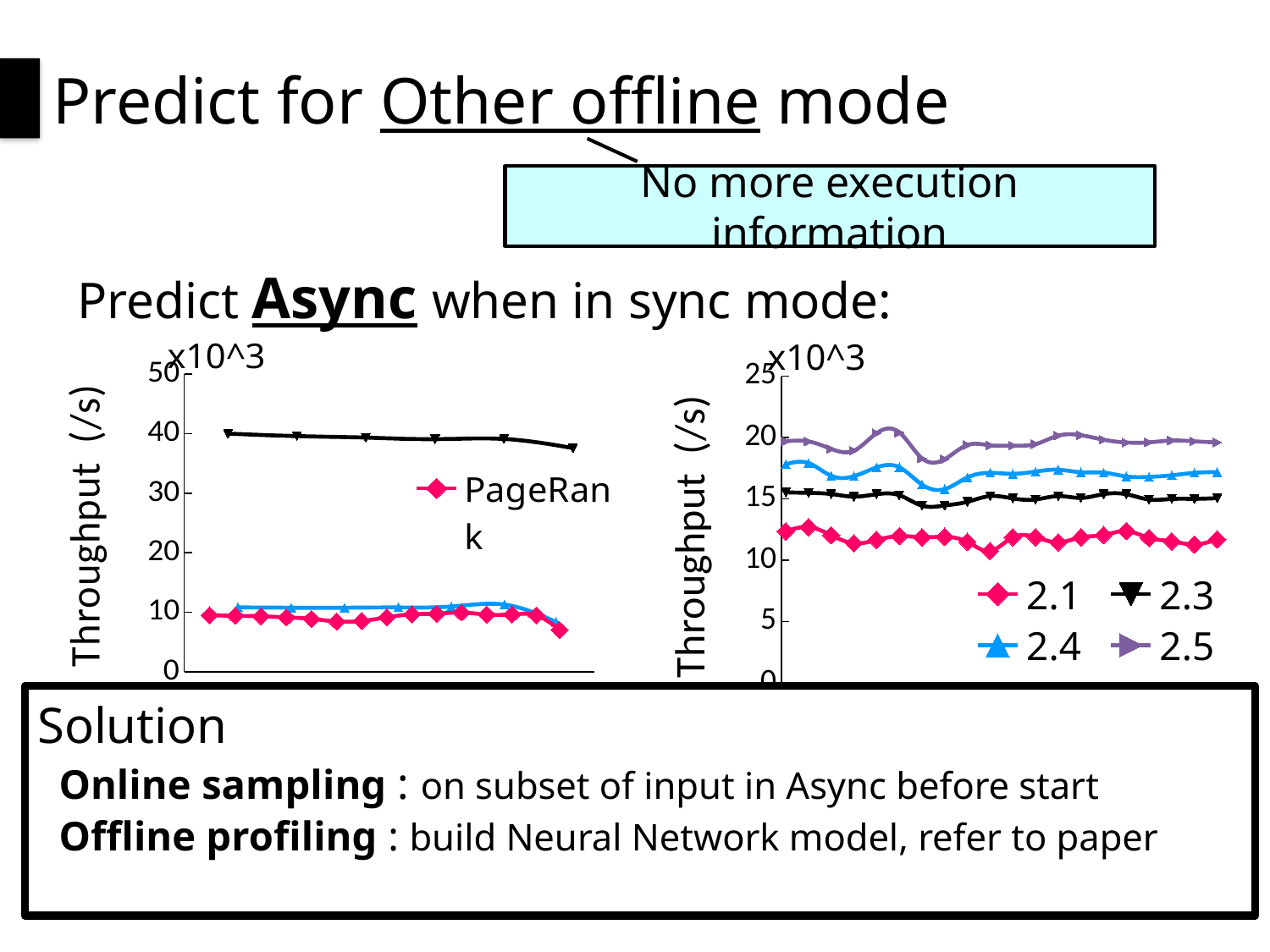
Which series does the legend of the left chart list? PageRank What kind of chart is the chart on the left of the slide? line chart In the right chart, which series has the highest throughput values? 2.5 What kind of chart is the chart on the right of the slide? line chart In the right chart, are the values for series 2.5 greater or less than 15? greater In the right chart, which series has the lowest throughput values? 2.1 In the right chart, are the values for series 2.1 greater or less than 15? less In the right chart, which series has larger values, 2.4 or 2.1? 2.4 How many series does the legend of the right chart list? 4 What is the y-axis label of the right chart? Throughput (/s) In the left chart, are the values of the PageRank series greater or less than 20? less